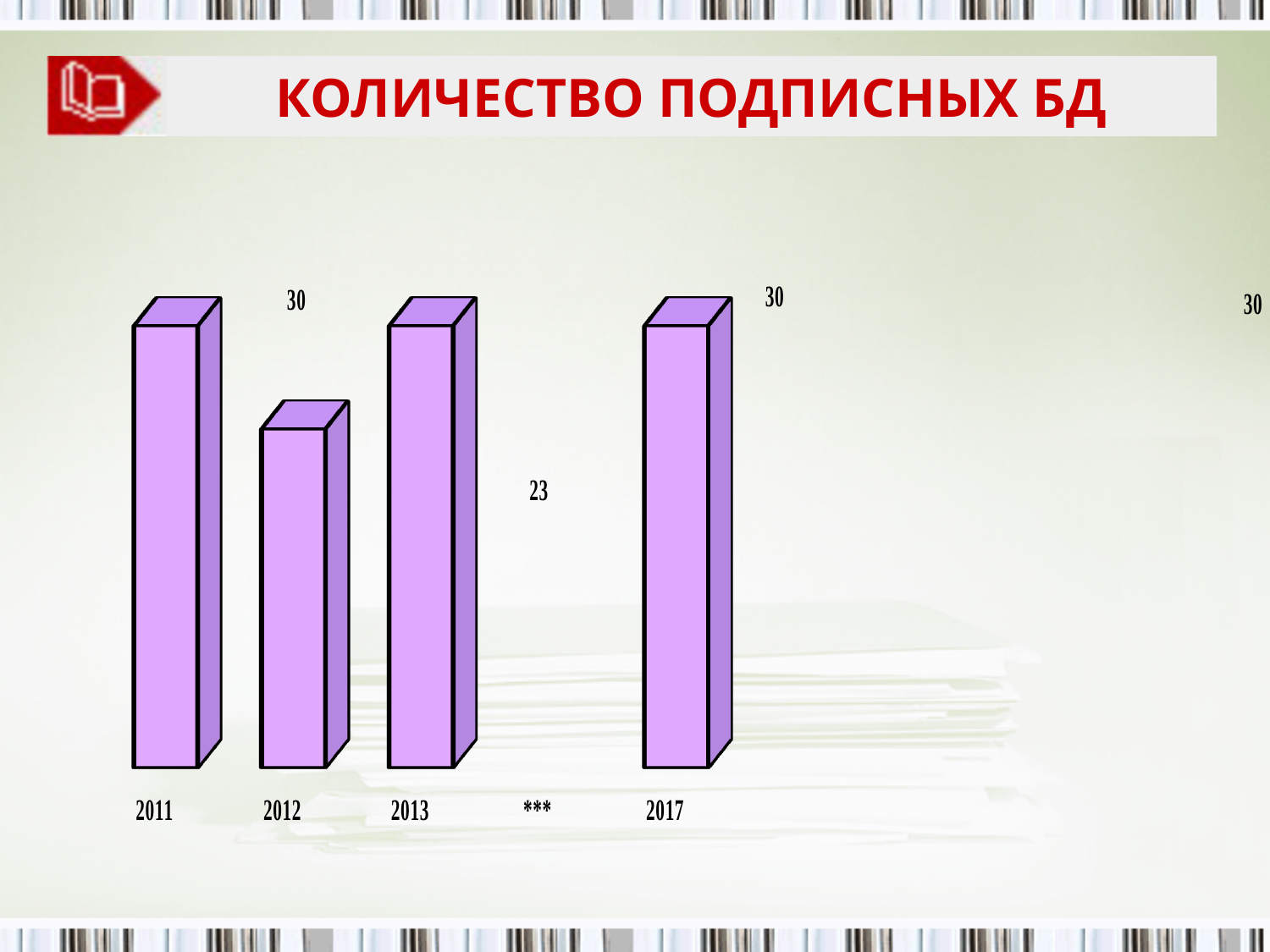
What is the value for 2012? 23 What is the value for 2017? 30 How many bars are plotted in the chart? 4 Which is larger, the value for 2012 or the value for 2017? 2017 Which year has the lowest bar in the chart? 2012 What is the value for 2011? 30 What is the difference between the values for 2013 and 2012? 7 Which is larger, the value for 2011 or the value for 2012? 2011 What type of chart is shown on the slide? bar chart What colour are the bars in the chart? purple Does the value rise or fall from 2012 to 2013? rise What is the title of the slide's chart? КОЛИЧЕСТВО ПОДПИСНЫХ БД